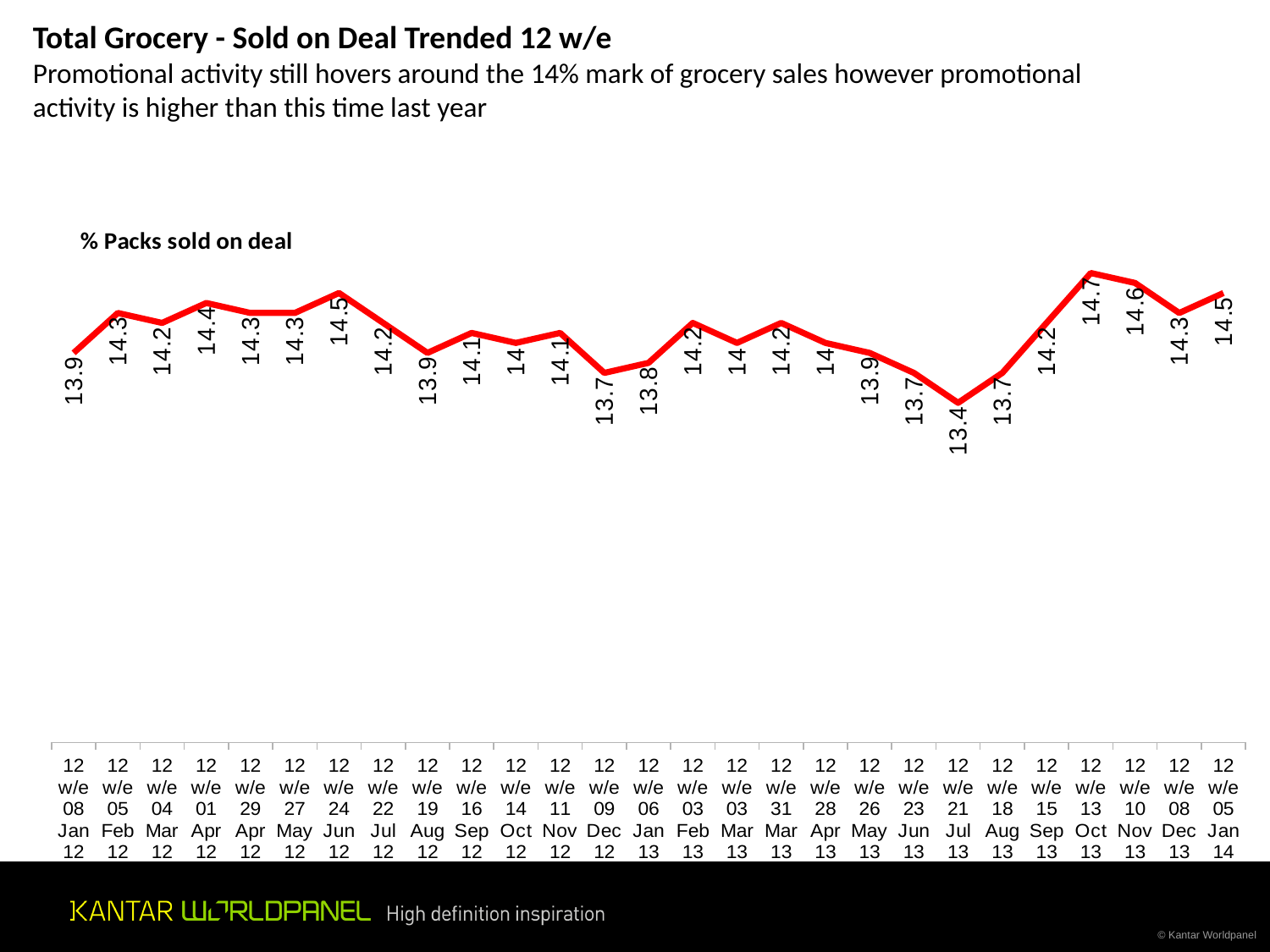
Which period has the lowest value? 12 w/e 21 Jul 13 Which is larger, the value for 12 w/e 05 Jan 14 or the value for 12 w/e 06 Jan 13? 12 w/e 05 Jan 14 How many data points are plotted on the chart? 27 What is the value for 12 w/e 24 Jun 12? 14.5 What is the difference between the value for 12 w/e 13 Oct 13 and the value for 12 w/e 21 Jul 13? 1.3 What type of chart is shown on the slide? line chart What is the value for 12 w/e 05 Jan 14? 14.5 What is the value for 12 w/e 09 Dec 12? 13.7 What is the title of the chart? % Packs sold on deal Which period has the highest value? 12 w/e 13 Oct 13 Do the values rise or fall between 12 w/e 21 Jul 13 and 12 w/e 13 Oct 13? rise What is the value for 12 w/e 08 Jan 12? 13.9